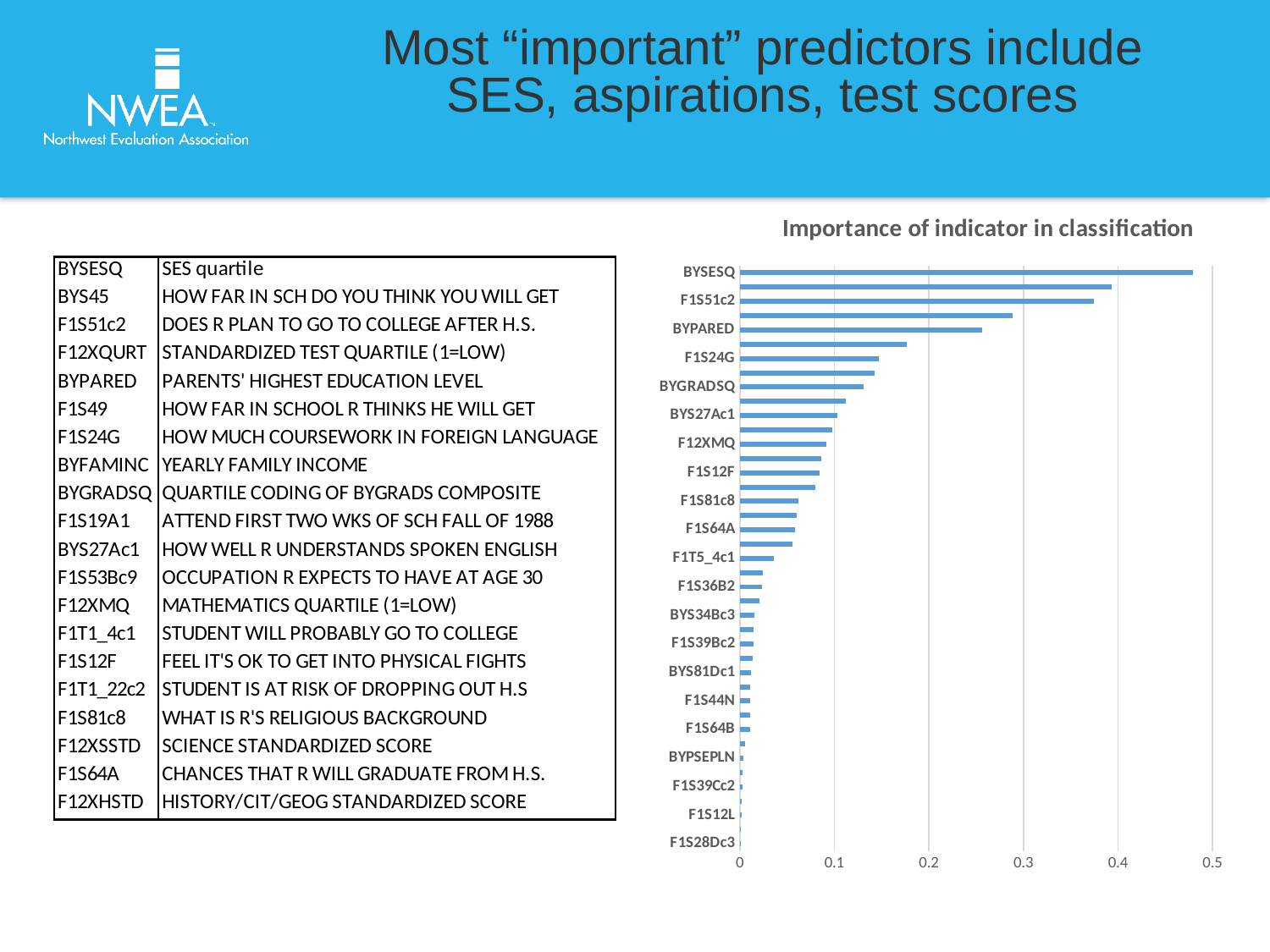
Do the bar values rise or fall moving from the top of the chart to the bottom? fall Which indicator has the highest importance in the chart? BYSESQ Is the value for F1S51c2 greater or less than 0.4? less Which has a larger value, F1S24G or F1S81c8? F1S24G Is the value for BYSESQ greater or less than 0.4? greater Is the value for F1S24G greater or less than 0.2? less Which has a larger value, BYSESQ or BYPARED? BYSESQ What kind of chart is shown on the slide? bar chart What is the title of the chart? Importance of indicator in classification